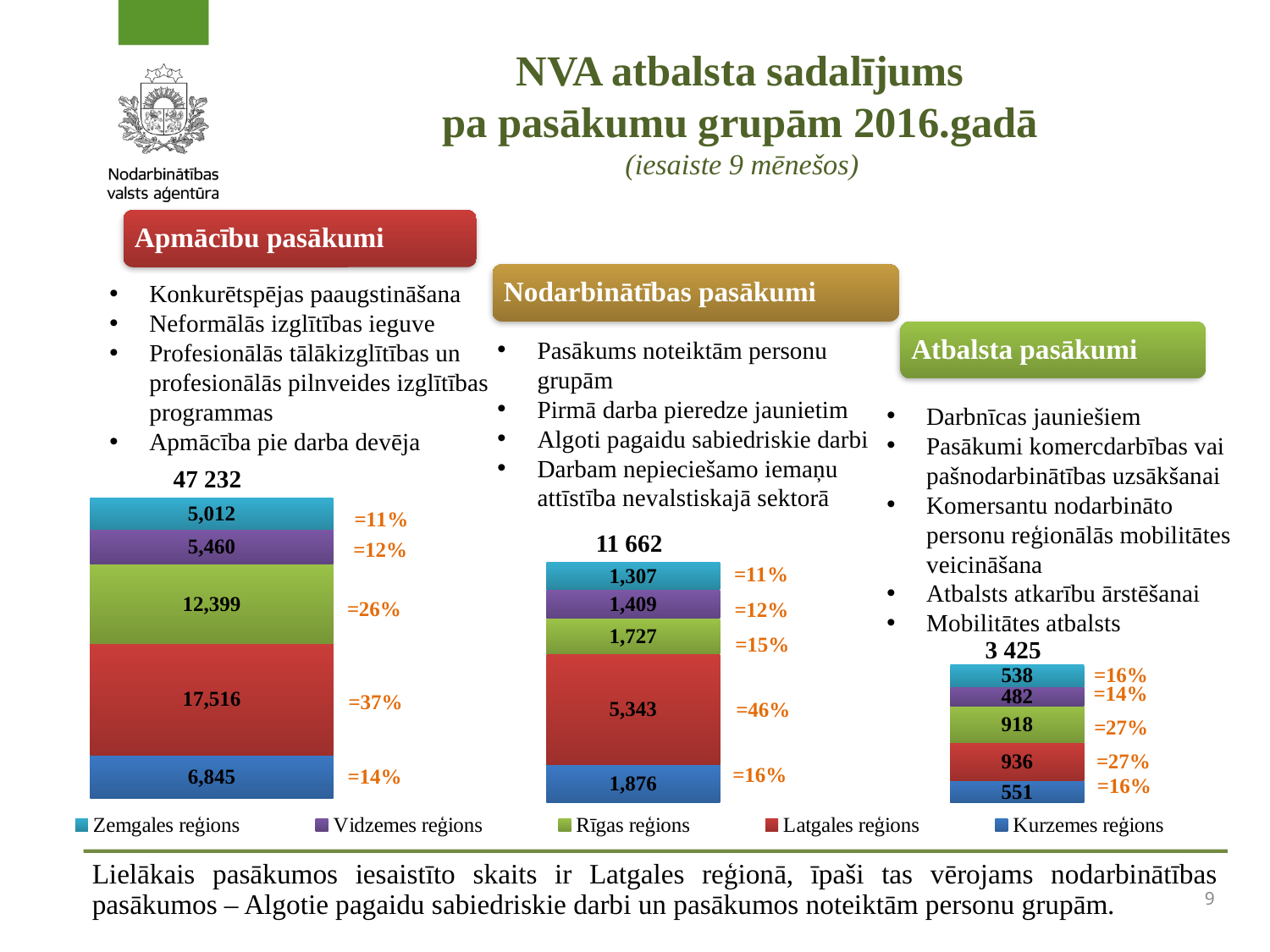
What type of chart is used to show the Apmācību pasākumi data? Stacked bar chart In the Apmācību pasākumi chart, what is the difference between the values for Rīgas reģions and Kurzemes reģions? 5,554 In the Atbalsta pasākumi chart, what percentage share is shown for Latgales reģions? =27% How many regions does the legend list? 5 In the Apmācību pasākumi chart, which region has the highest value? Latgales reģions In the Nodarbinātības pasākumi chart, which region has the lowest value? Zemgales reģions What is the total shown for the Nodarbinātības pasākumi stacked bar? 11 662 In the Atbalsta pasākumi chart, which region has the lowest value? Vidzemes reģions In the Nodarbinātības pasākumi chart, which is larger: the value for Vidzemes reģions or Zemgales reģions? Vidzemes reģions In the Nodarbinātības pasākumi chart, what is the value for Kurzemes reģions? 1,876 In the Apmācību pasākumi chart, what is the value for Latgales reģions? 17,516 In the Atbalsta pasākumi chart, what is the value for Rīgas reģions? 918